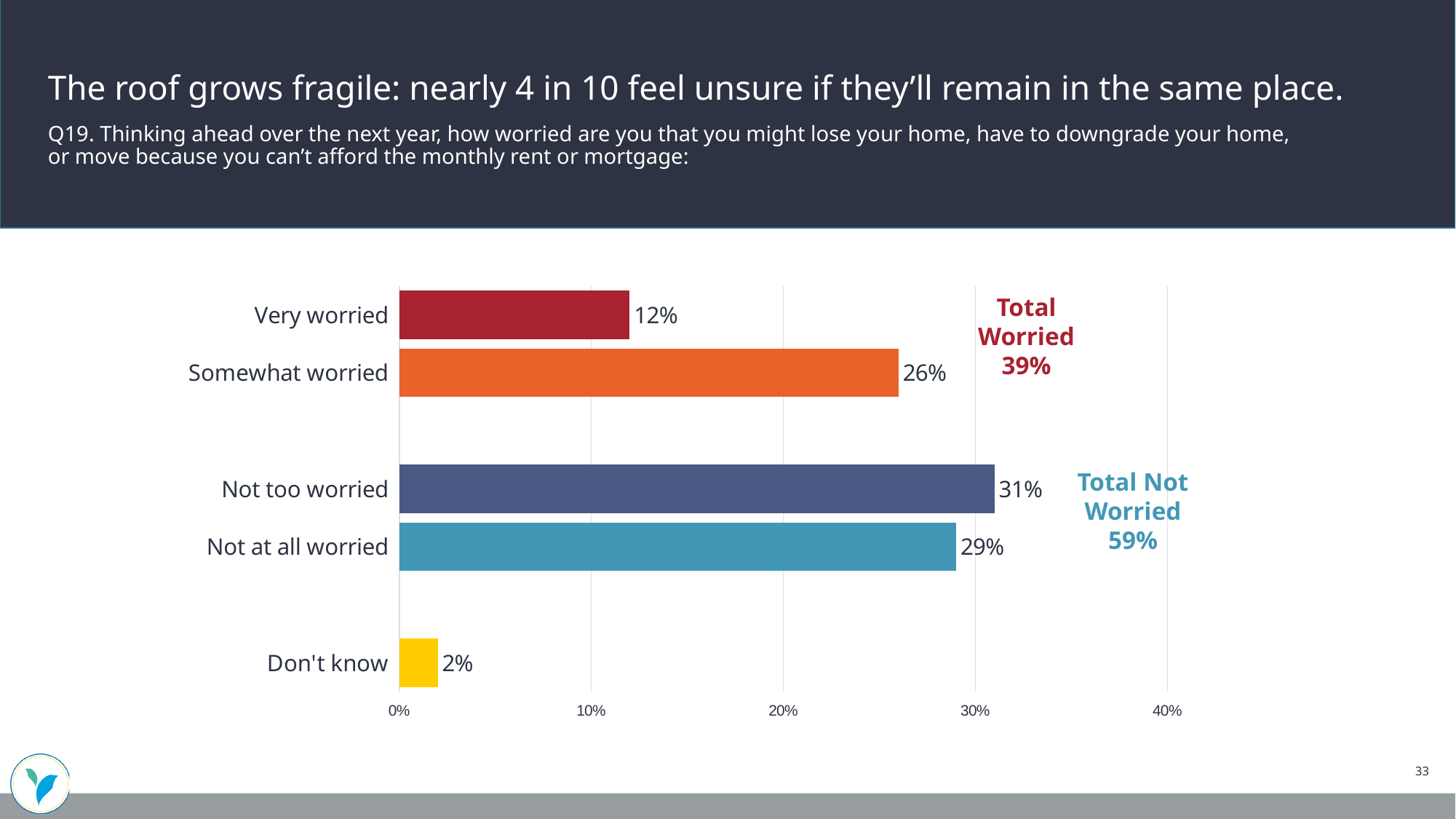
What percentage of respondents answered 'Don't know'? 2% Which response category has the lowest percentage? Don't know What percentage of respondents are somewhat worried? 26% What type of chart is shown on the slide? Bar chart What percentage of respondents are not too worried? 31% What is the Total Not Worried percentage shown on the slide? 59% How many response categories are shown in the chart? 5 What is the difference in percentage points between 'Not too worried' and 'Very worried'? 19 percentage points Which is larger, the percentage for 'Somewhat worried' or 'Not at all worried'? Not at all worried What percentage of respondents are very worried? 12% Which response category has the highest percentage? Not too worried What is the Total Worried percentage shown on the slide? 39%